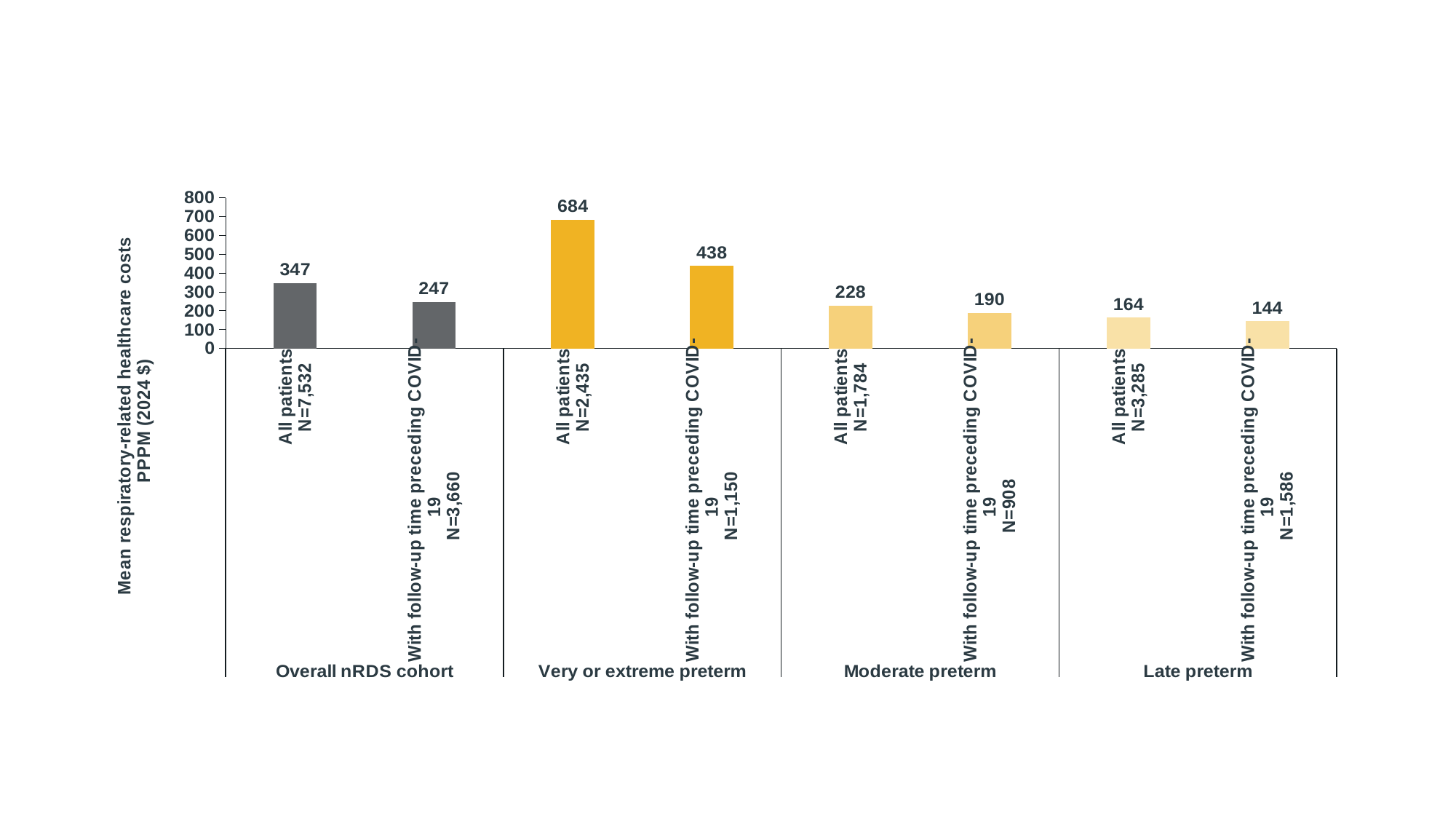
What is the label of the y axis? Mean respiratory-related healthcare costs PPPM (2024 $) What kind of chart is shown? Bar chart Which bar has the lowest value on the chart? With follow-up time preceding COVID-19, Late preterm (144) What is the N for all patients in the Overall nRDS cohort? 7,532 What is the difference between the all patients values for the Very or extreme preterm and Overall nRDS cohort groups? 337 Which is larger: the all patients value for Moderate preterm or the all patients value for Late preterm? Moderate preterm What is the value for patients with follow-up time preceding COVID-19 in the Very or extreme preterm group? 438 What is the value for all patients in the Late preterm group? 164 What is the difference between the all patients value and the follow-up preceding COVID-19 value in the Moderate preterm group? 38 How many bars are plotted on the chart? 8 What is the mean respiratory-related healthcare cost PPPM for all patients in the Overall nRDS cohort? 347 Which bar has the highest value on the chart? All patients, Very or extreme preterm (684)